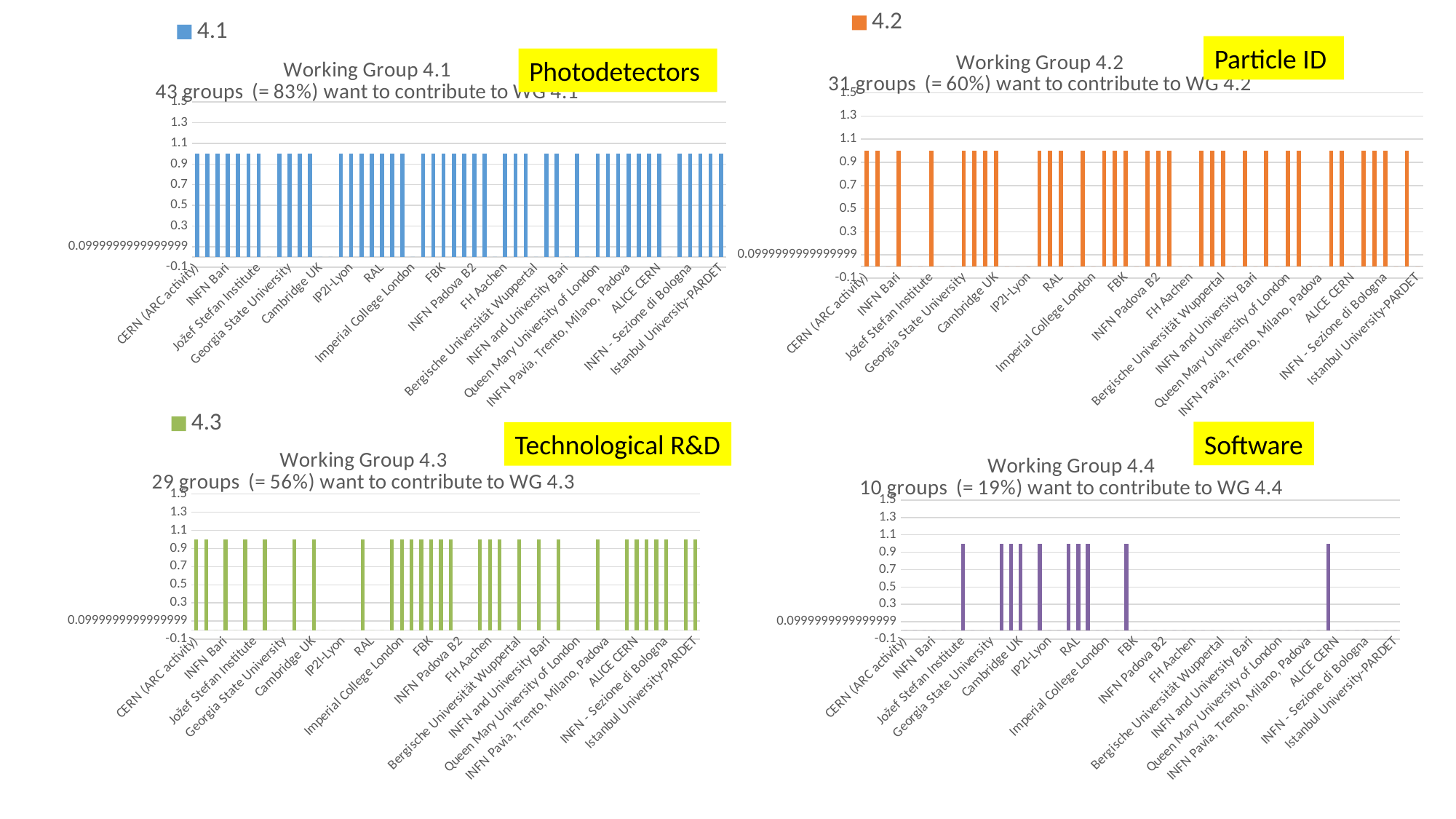
According to the chart titles, which working group has the most groups wanting to contribute? Working Group 4.1 How many series does the legend of the Working Group 4.3 chart list? 1 What kind of chart is the Working Group 4.1 chart? bar chart What is the legend entry of the Working Group 4.2 chart? 4.2 How many series does the legend of the Working Group 4.1 chart list? 1 In the Working Group 4.3 chart, is the value for CERN (ARC activity) greater or less than 0.5? greater What kind of chart is the Working Group 4.4 chart? bar chart Which working group chart is labelled with the yellow tag 'Software'? Working Group 4.4 According to the chart titles, how many groups want to contribute to WG 4.2? 31 groups In the Working Group 4.2 chart, is the value for CERN (ARC activity) greater or less than 0.5? greater According to the chart titles, what percentage of groups want to contribute to WG 4.4? 19% In the Working Group 4.1 chart, is the value for CERN (ARC activity) greater or less than 0.5? greater